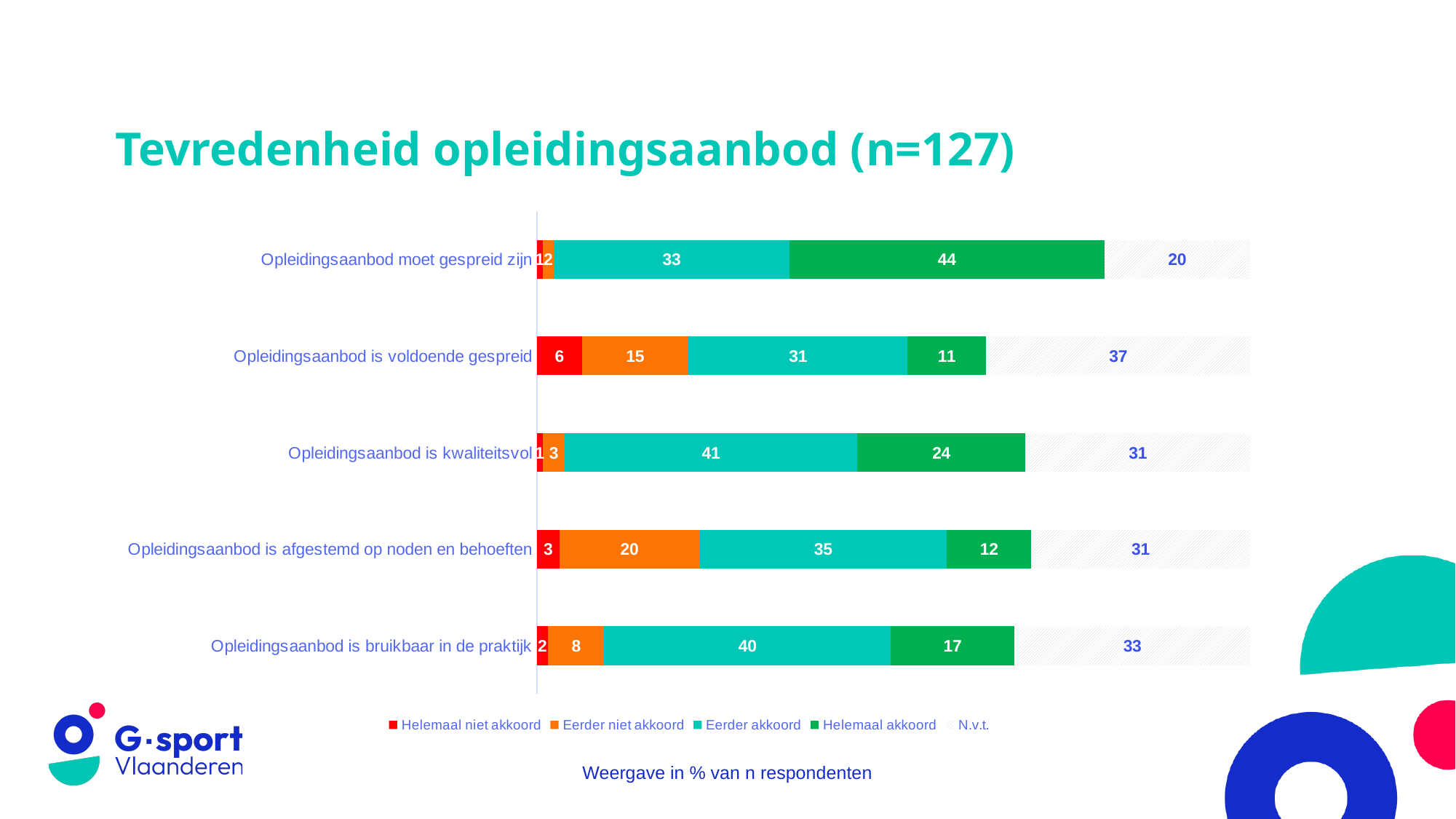
What kind of chart is shown on the slide? Stacked bar chart How many categories (statements) are plotted in the chart? 5 Which statement has the lowest 'Helemaal akkoord' value? Opleidingsaanbod is voldoende gespreid Which statement has the highest 'Helemaal akkoord' value? Opleidingsaanbod moet gespreid zijn What is the 'N.v.t.' value for 'Opleidingsaanbod is voldoende gespreid'? 37 What is the total of the stacked bar for 'Opleidingsaanbod is bruikbaar in de praktijk'? 100 Which is larger: the 'Helemaal niet akkoord' value for 'Opleidingsaanbod is voldoende gespreid' or for 'Opleidingsaanbod is afgestemd op noden en behoeften'? Opleidingsaanbod is voldoende gespreid How many series does the legend list? 5 What is the 'Helemaal akkoord' value for 'Opleidingsaanbod moet gespreid zijn'? 44 What is the difference between the 'Eerder akkoord' values for 'Opleidingsaanbod is kwaliteitsvol' and 'Opleidingsaanbod is voldoende gespreid'? 10 What is the 'Eerder niet akkoord' value for 'Opleidingsaanbod is afgestemd op noden en behoeften'? 20 What is the 'Eerder akkoord' value for 'Opleidingsaanbod is bruikbaar in de praktijk'? 40